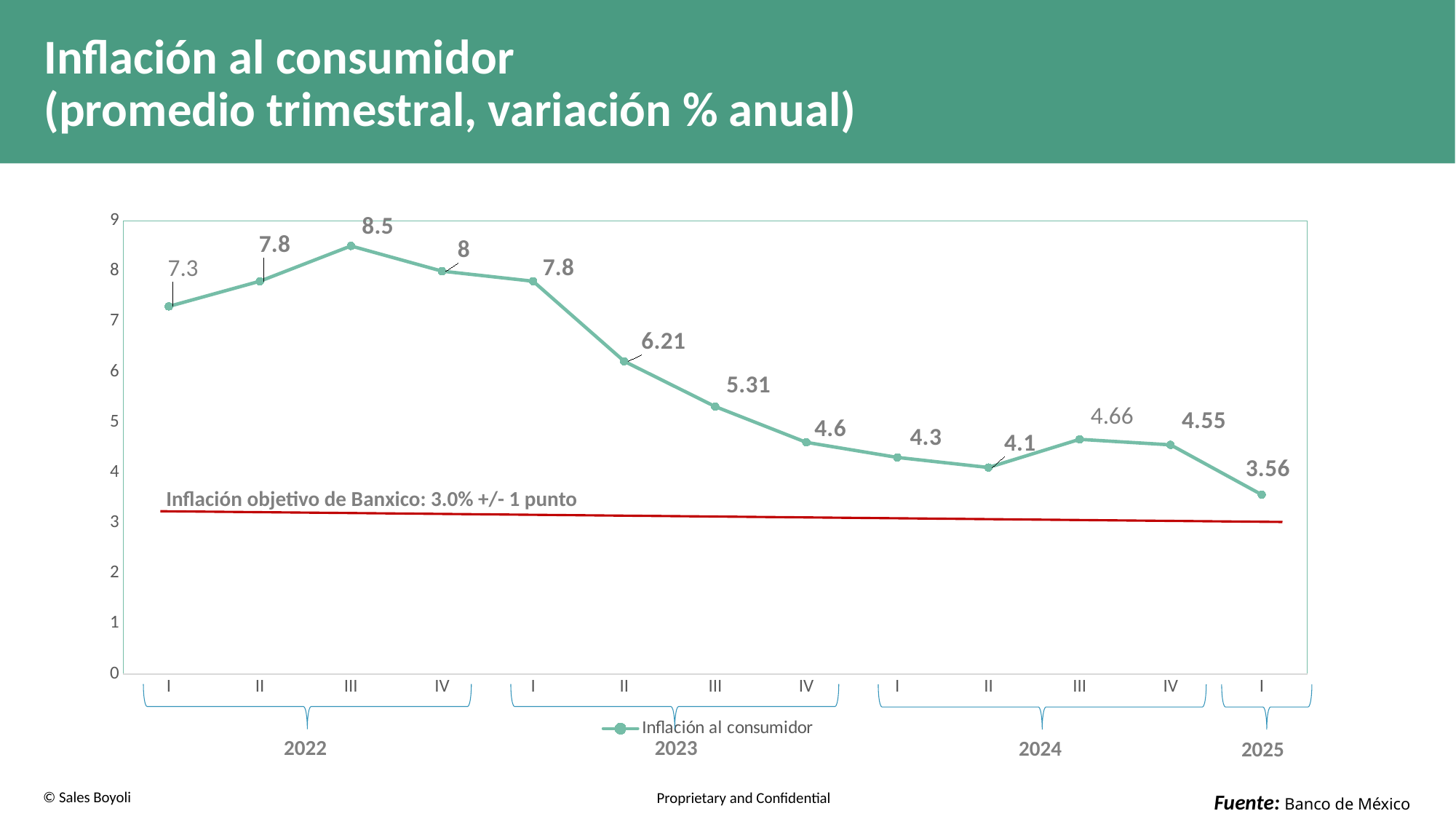
What type of chart is shown on the slide? line chart What is the difference between the value for quarter III of 2022 and quarter I of 2025? 4.94 Which is larger, the value for quarter IV of 2023 or quarter I of 2024? IV 2023 What is the value for quarter III of 2024? 4.66 What is the value for quarter I of 2025? 3.56 What is the value for quarter II of 2023? 6.21 Which quarter has the lowest inflation value? I 2025 What is the value for quarter III of 2022? 8.5 How many series does the legend list? 1 What is the overall trend of consumer inflation from quarter III of 2022 to quarter I of 2025? falling Which quarter has the highest inflation value? III 2022 How many quarterly data points are plotted on the chart? 13